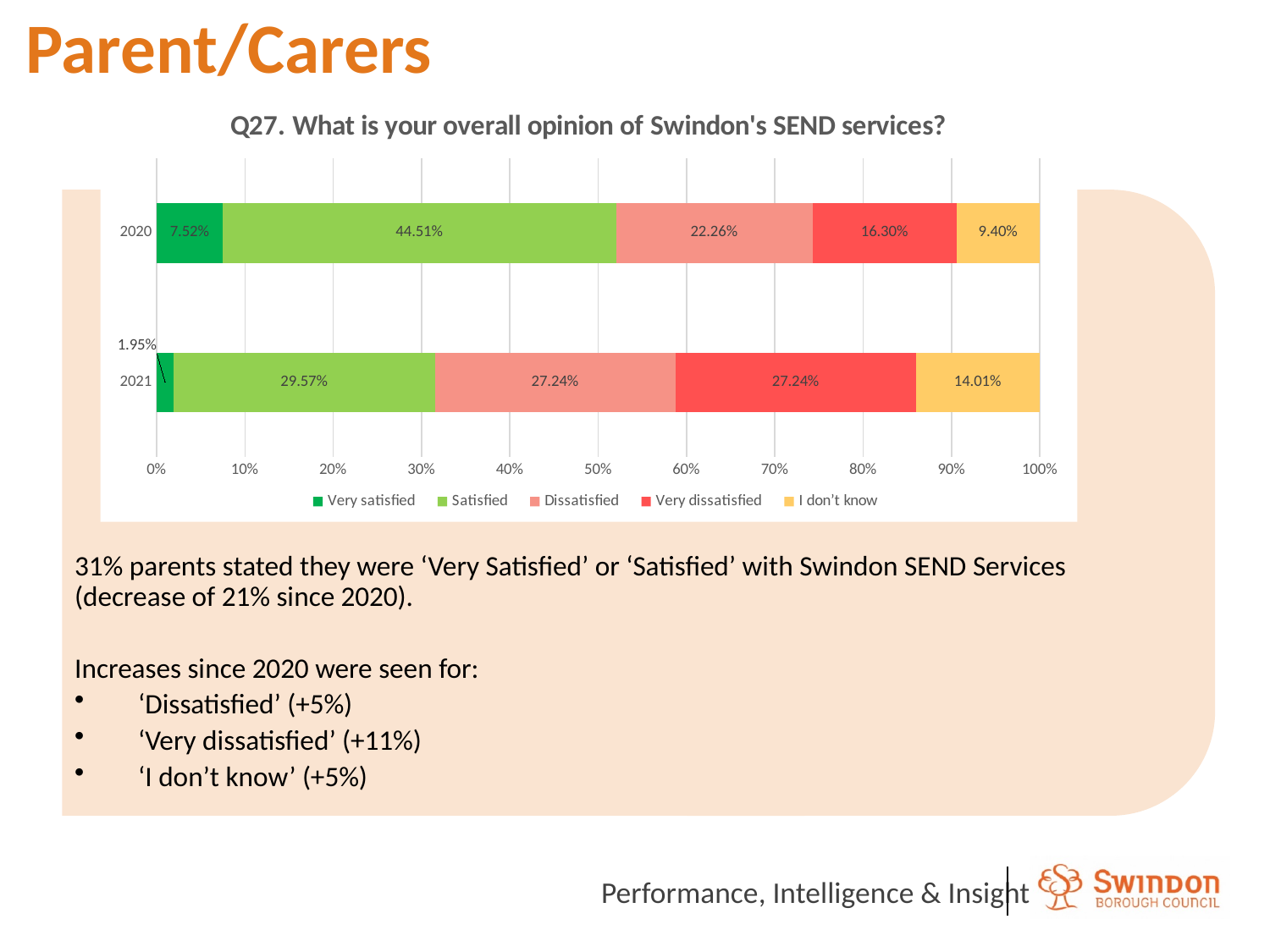
How many years are shown on the chart? 2 What is the 'Very satisfied' value for 2021? 1.95% Which response category has the smallest share in the 2021 bar? Very satisfied What is the difference between the 'Satisfied' values for 2020 and 2021? 14.94% What is the 'I don't know' value for 2020? 9.40% How many series does the legend list? 5 What kind of chart is shown on the slide? Stacked bar chart What percentage of parent/carers were 'Satisfied' in 2020? 44.51% What is the title of the chart? Q27. What is your overall opinion of Swindon's SEND services? What percentage of parent/carers were 'Very dissatisfied' in 2021? 27.24% Which year has the larger 'I don't know' share, 2020 or 2021? 2021 Which response category has the largest share in the 2020 bar? Satisfied